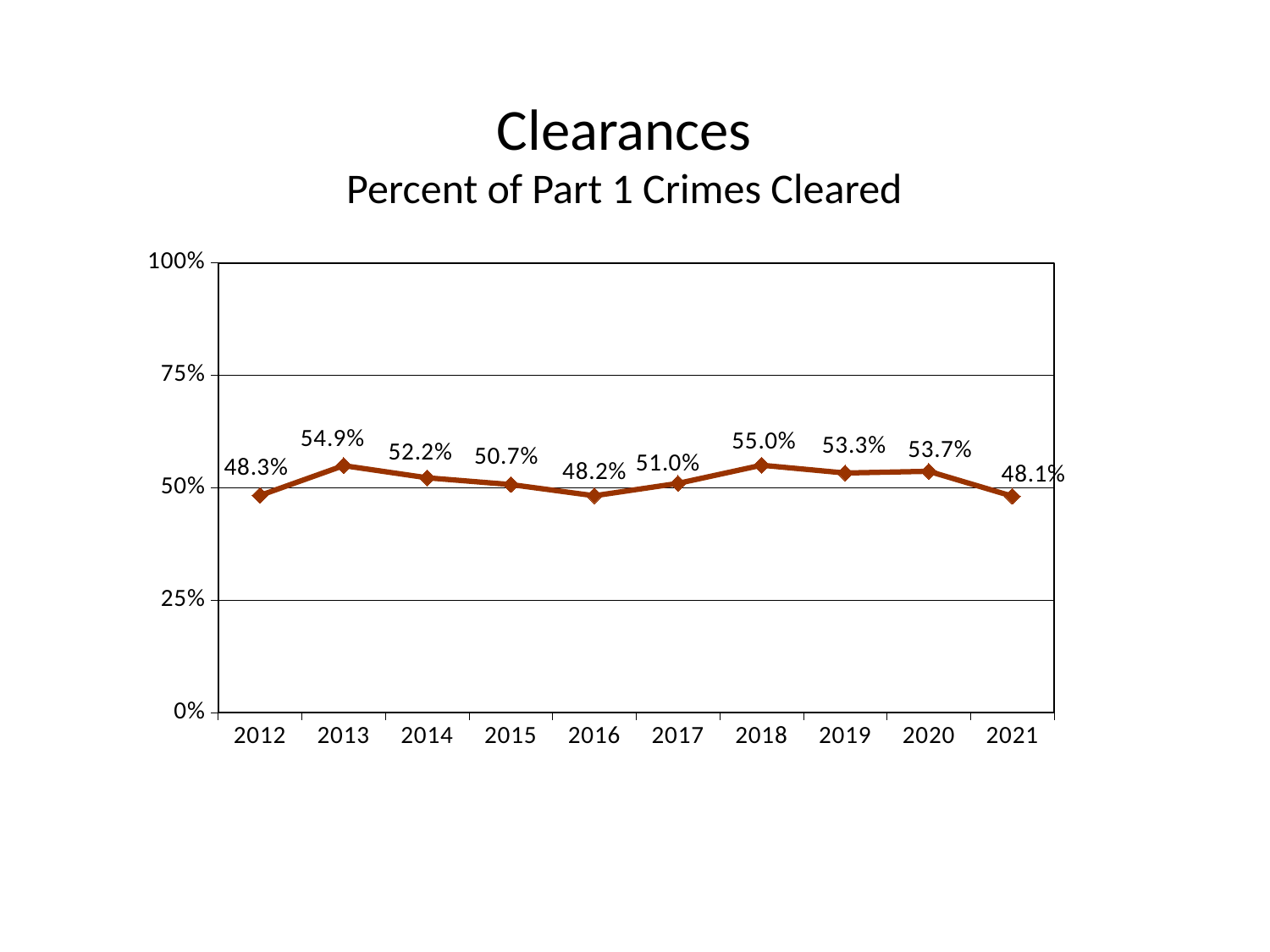
Which year has a higher clearance rate, 2014 or 2019? 2019 What is the difference between the clearance rates for 2018 and 2016? 6.8% Is the value for 2020 greater or less than 50%? greater What is the clearance rate shown for 2021? 48.1% What percent of Part 1 crimes were cleared in 2013? 54.9% Did the clearance rate rise or fall from 2020 to 2021? Fall Which year has the lowest percent of Part 1 crimes cleared? 2021 What is the subtitle of the chart? Percent of Part 1 Crimes Cleared Which year has the highest percent of Part 1 crimes cleared? 2018 What value is plotted for 2016? 48.2% What kind of chart is shown on the slide? Line chart How many years are plotted on the chart? 10